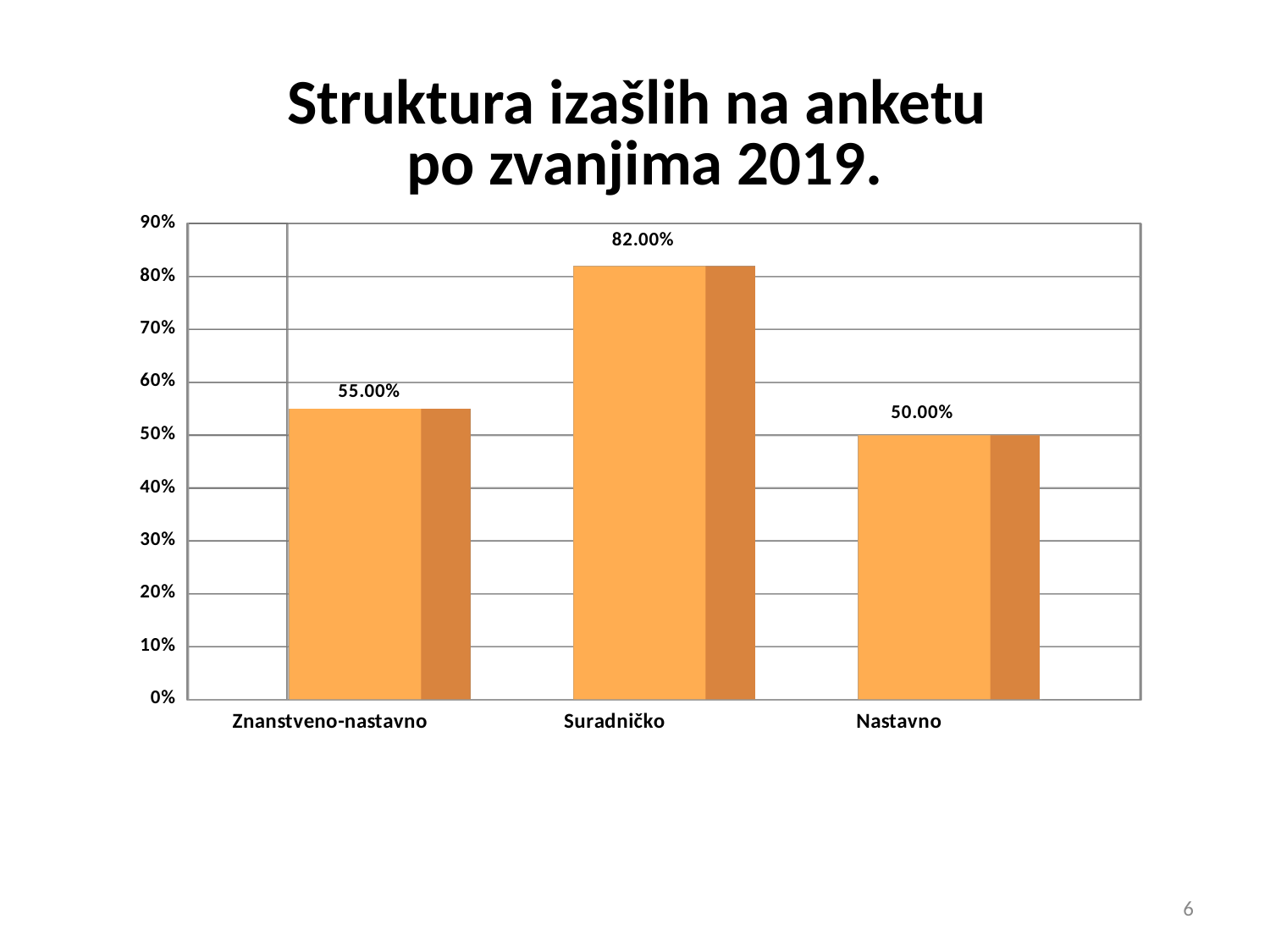
What is the difference between the values for Znanstveno-nastavno and Nastavno? 5.00% What is the title of the chart on the slide? Struktura izašlih na anketu po zvanjima 2019. What kind of chart is shown on the slide? bar chart Which category has the highest value? Suradničko Is the value for Suradničko greater or less than 80%? greater Which category has the lowest value? Nastavno What is the value for Nastavno? 50.00% What is the value for Znanstveno-nastavno? 55.00% What is the value for Suradničko? 82.00% Which is larger, the value for Znanstveno-nastavno or the value for Suradničko? Suradničko How many categories are shown on the chart? 3 What is the difference between the values for Suradničko and Nastavno? 32.00%